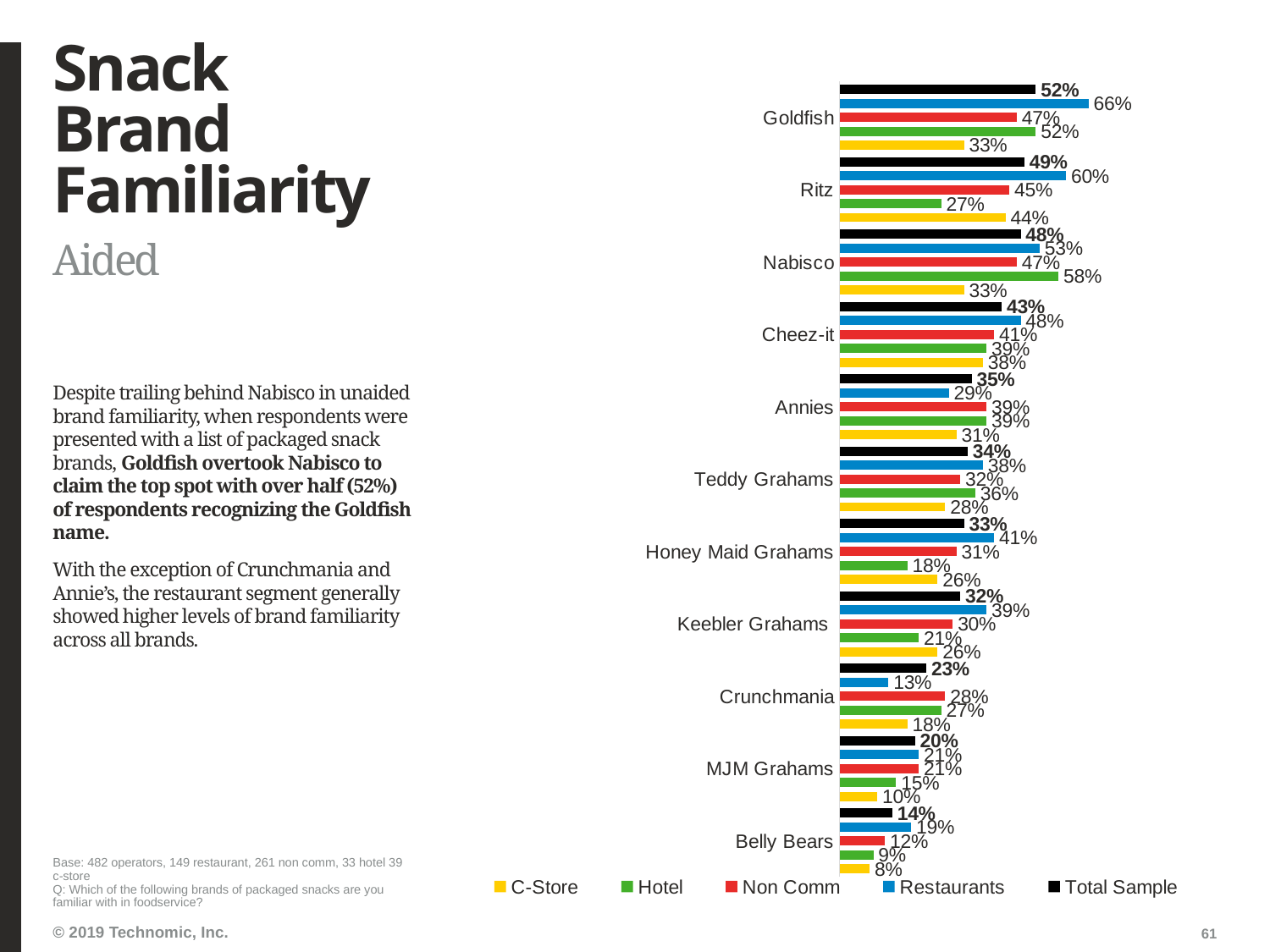
What is the Restaurants value for Ritz? 60% What type of chart is shown on the slide? Bar chart Which colour represents the Restaurants series in the chart? Blue Which brand has the highest Restaurants familiarity value? Goldfish What is the Hotel value for Nabisco? 58% What is the C-Store value for MJM Grahams? 10% What is the difference between the Restaurants and C-Store values for Goldfish? 33% For Crunchmania, which is larger: the Non Comm value or the Restaurants value? Non Comm Which brand has the lowest Total Sample familiarity? Belly Bears How many brands are shown in the chart? 11 How many series does the legend list? 5 What is the Total Sample familiarity value for Goldfish? 52%